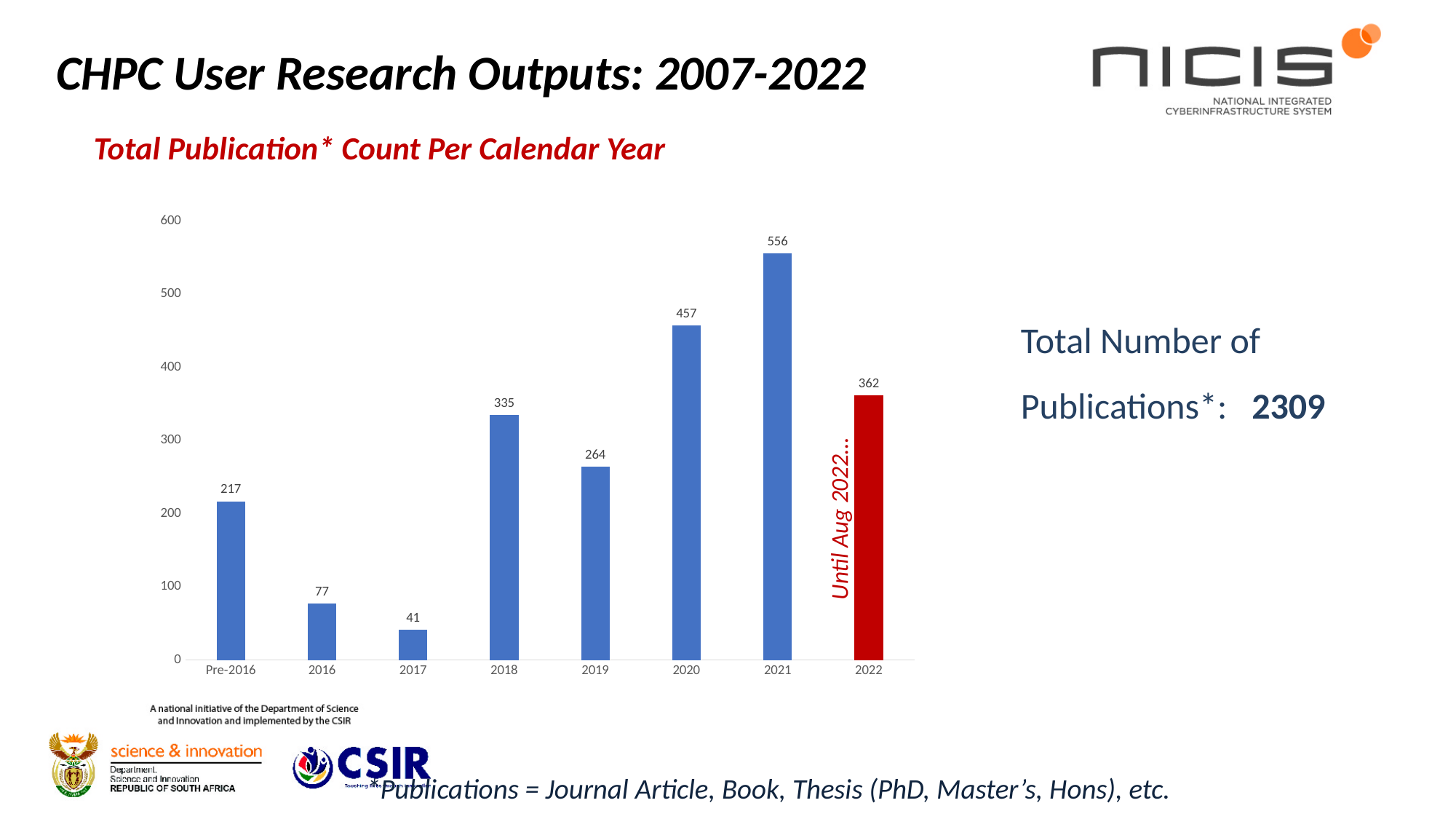
What is the publication count for 2021? 556 What is the difference between the publication counts for 2018 and 2019? 71 Do the publication counts rise or fall from 2017 to 2018? Rise What kind of chart is shown on the slide? Bar chart What is the difference between the publication counts for 2021 and 2020? 99 Which year has the lowest publication count? 2017 Which bar is coloured red instead of blue? 2022 What is the publication count for 2022? 362 Which year has the highest publication count? 2021 What is the publication count for Pre-2016? 217 How many categories are shown on the x axis? 8 Which has a higher publication count, 2016 or 2019? 2019